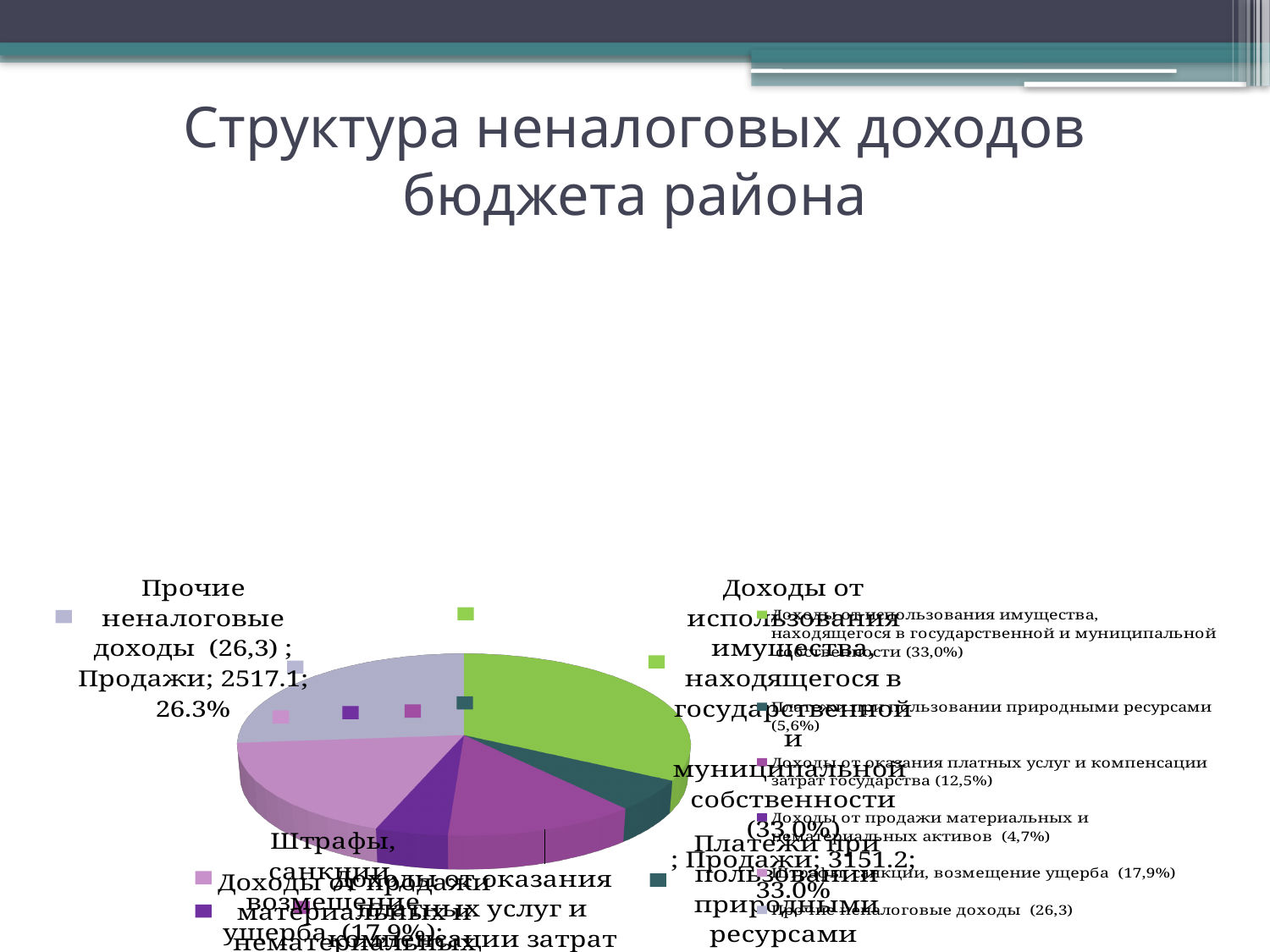
What is the value shown for 'Прочие неналоговые доходы'? 2517.1 Which category has the smallest share of the pie? Доходы от продажи материальных и нематериальных активов How many categories (slices) does the pie chart have? 6 What is the value shown for 'Доходы от использования имущества, находящегося в государственной и муниципальной собственности'? 3151.2 Which category has the largest share of the pie? Доходы от использования имущества, находящегося в государственной и муниципальной собственности What is the title of the slide containing the chart? Структура неналоговых доходов бюджета района What is the difference between the values for 'Доходы от использования имущества' (3151.2) and 'Прочие неналоговые доходы' (2517.1)? 634.1 What kind of chart is shown on the slide? pie chart Which is larger: the share of 'Штрафы, санкции, возмещение ущерба' or the share of 'Доходы от оказания платных услуг и компенсации затрат государства'? Штрафы, санкции, возмещение ущерба What share of the pie is 'Платежи при пользовании природными ресурсами'? 5,6% What share of the pie is 'Доходы от оказания платных услуг и компенсации затрат государства'? 12,5% What share of the pie is 'Штрафы, санкции, возмещение ущерба'? 17,9%